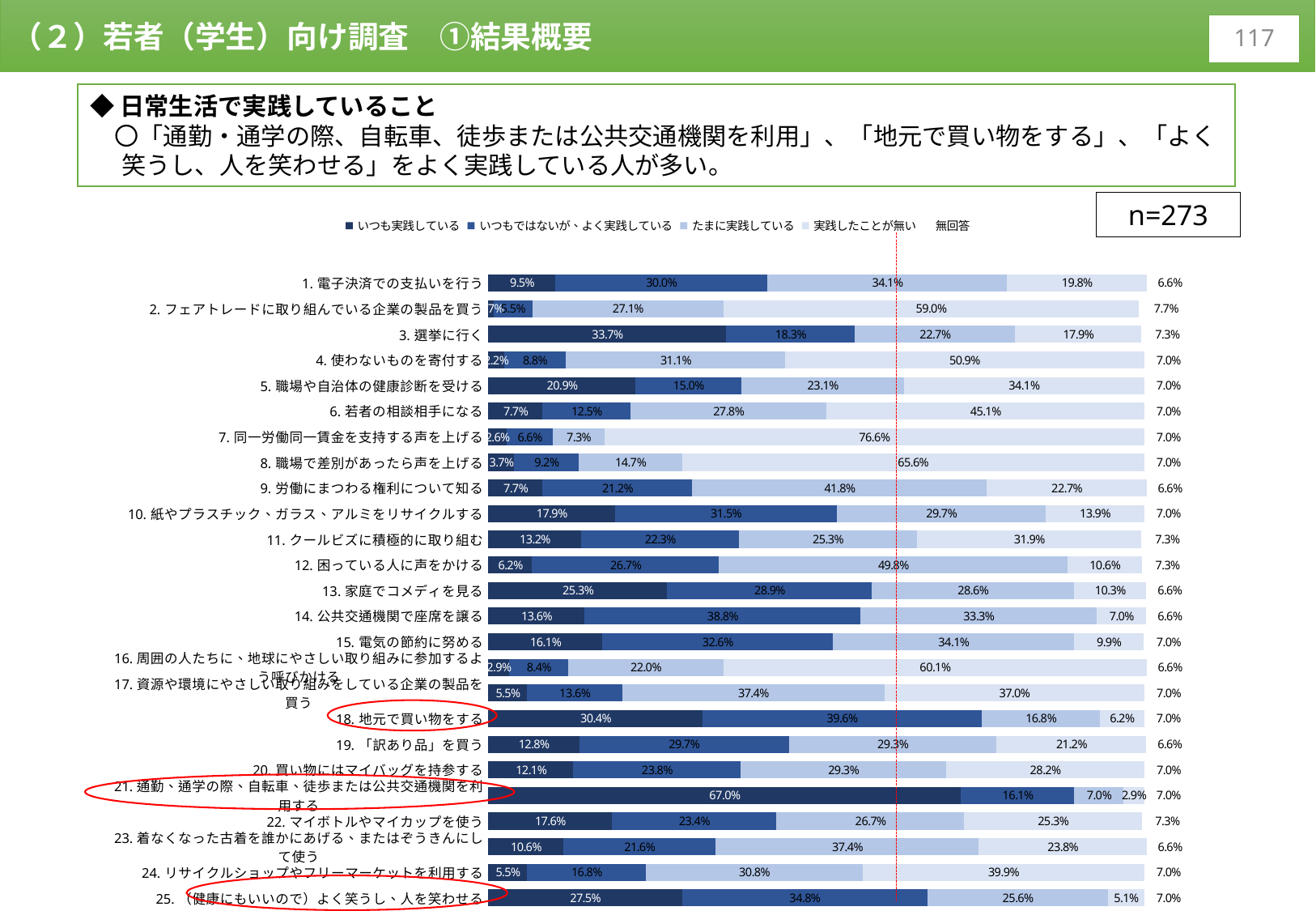
How many series does the legend list? 5 Which item has the highest value for 実践したことが無い? 7. 同一労働同一賃金を支持する声を上げる Which item has the highest value for いつも実践している? 21. 通勤、通学の際、自転車、徒歩または公共交通機関を利用する What is the value of たまに実践している for item 25 (よく笑うし、人を笑わせる)? 25.6% What is the value of いつも実践している for item 21 (通勤、通学の際、自転車、徒歩または公共交通機関を利用する)? 67.0% What is the value of 実践したことが無い for item 7 (同一労働同一賃金を支持する声を上げる)? 76.6% What is the difference between the いつも実践している values for item 21 (67.0%) and item 18 (30.4%)? 36.6 percentage points What is the value of いつもではないが、よく実践している for item 18 (地元で買い物をする)? 39.6% What sample size (n) is shown on the slide? n=273 What kind of chart is shown on the slide? Stacked bar chart How many categories (items) are plotted in the chart? 25 Which is larger: the いつも実践している value for item 3 (選挙に行く) or for item 13 (家庭でコメディを見る)? 3. 選挙に行く